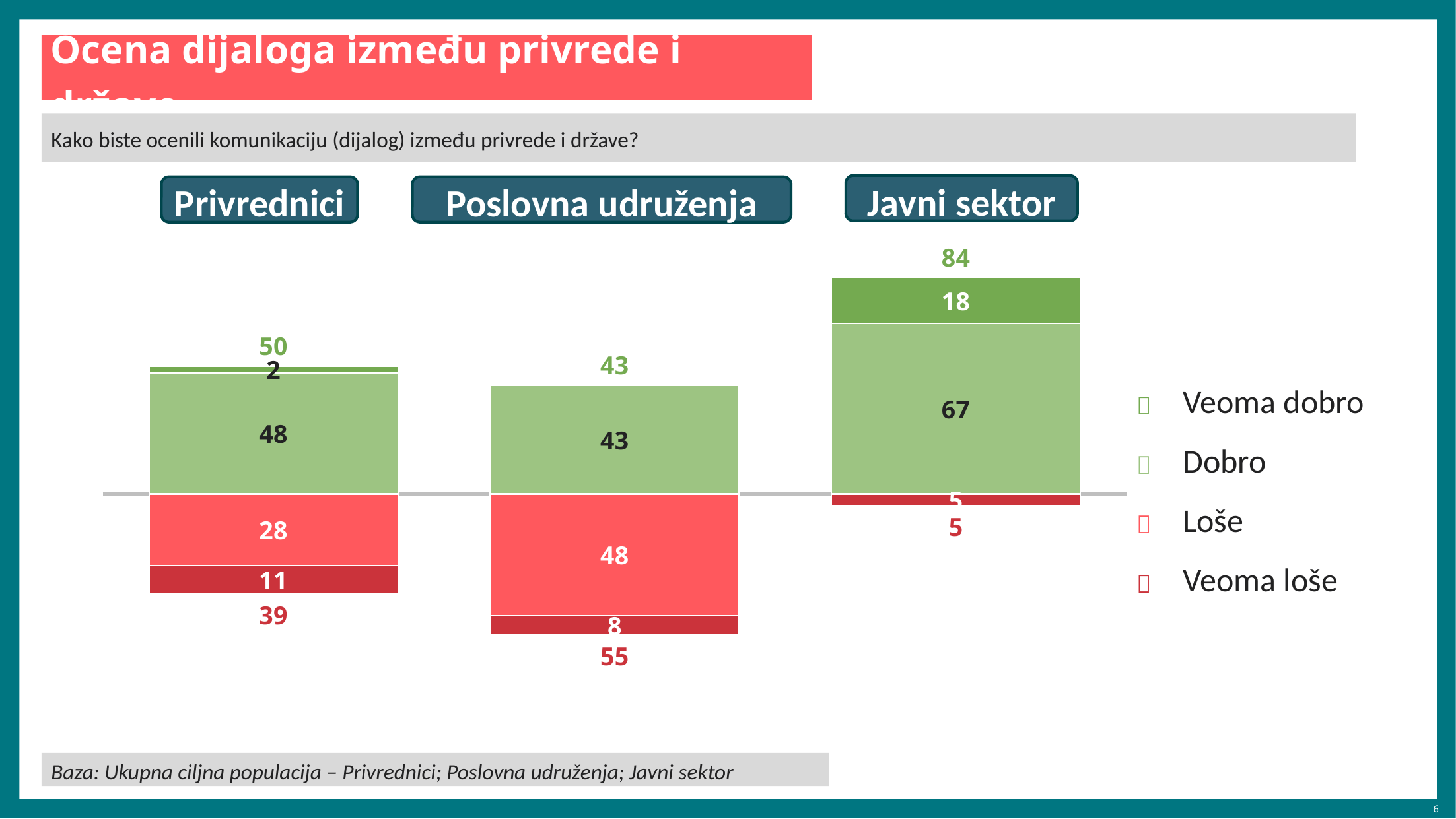
What is the 'Veoma dobro' value for Javni sektor? 18 What is the 'Loše' value for Poslovna udruženja? 48 What is the difference between the 'Dobro' values for Javni sektor and Poslovna udruženja? 24 What is the 'Dobro' value for Privrednici? 48 What kind of chart is shown on the slide? stacked bar chart Which group has the lowest combined negative (Loše + Veoma loše) total? Javni sektor How many groups (categories) are plotted in the chart? 3 What is the 'Veoma loše' value for Privrednici? 11 How many series does the legend list? 4 What is the combined negative total (Loše + Veoma loše) shown for Poslovna udruženja? 55 Which group has the highest combined positive (Veoma dobro + Dobro) total? Javni sektor Which is larger: the 'Loše' value for Privrednici or the 'Loše' value for Poslovna udruženja? Poslovna udruženja